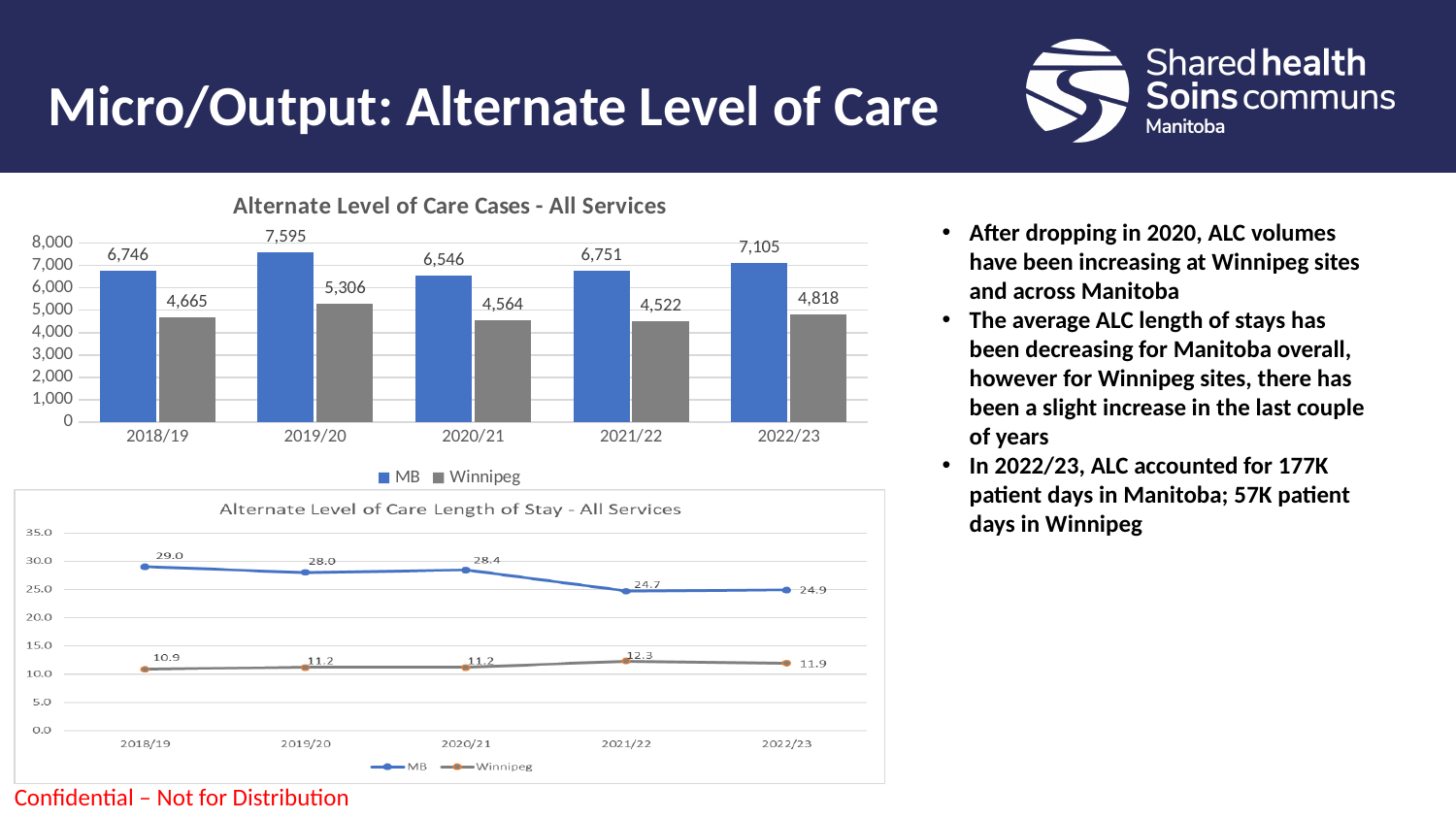
In the 'Alternate Level of Care Length of Stay - All Services' chart, is the MB value larger than the Winnipeg value in 2018/19? Yes How many years are shown on the x axis of the 'Alternate Level of Care Length of Stay - All Services' chart? 5 In the 'Alternate Level of Care Cases - All Services' chart, what is the Winnipeg value for 2022/23? 4,818 In the 'Alternate Level of Care Cases - All Services' chart, what is the difference between the MB and Winnipeg values for 2018/19? 2,081 How many series does the legend of the 'Alternate Level of Care Cases - All Services' chart list? 2 In the 'Alternate Level of Care Length of Stay - All Services' chart, what is the MB value for 2021/22? 24.7 In the 'Alternate Level of Care Cases - All Services' chart, which year has the highest MB value? 2019/20 In the 'Alternate Level of Care Cases - All Services' chart, which year has the lowest Winnipeg value? 2021/22 What kind of chart is 'Alternate Level of Care Cases - All Services'? bar chart In the 'Alternate Level of Care Length of Stay - All Services' chart, which year has the highest Winnipeg value? 2021/22 In the 'Alternate Level of Care Cases - All Services' chart, what is the MB value for 2019/20? 7,595 In the 'Alternate Level of Care Cases - All Services' chart, is the MB value for 2020/21 greater or less than 7,000? less